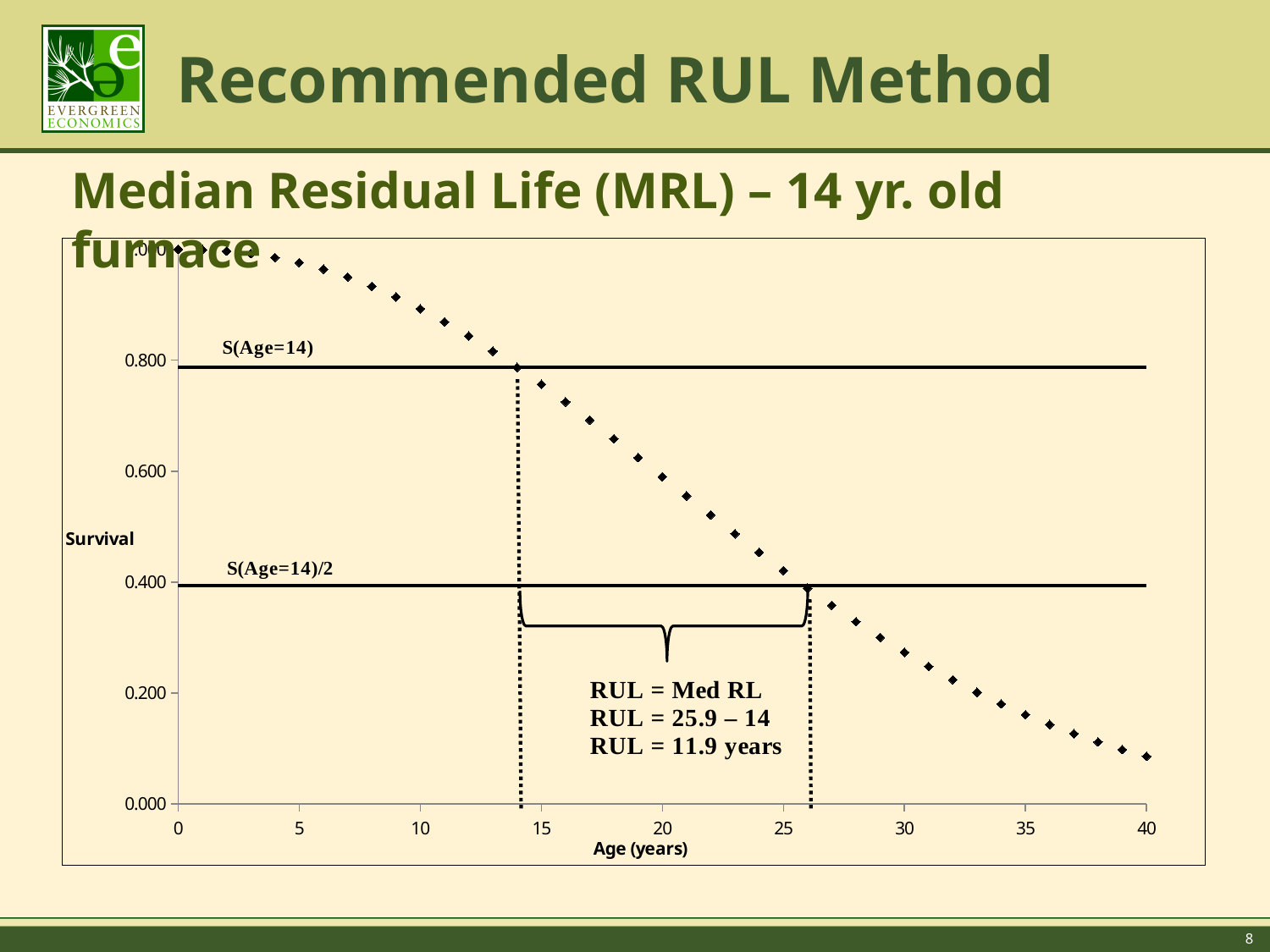
Is the survival value at age 30 greater or less than 0.400? less What is the RUL value stated in the annotation on the chart? 11.9 years Is the survival value at age 5 greater or less than 0.800? greater What kind of chart is shown on the slide? scatter chart Which has the higher survival value, age 10 or age 25? age 10 What label is given to the upper horizontal line on the chart? S(Age=14) Do the survival values rise or fall as age increases along the x axis? fall Is the survival value at age 20 greater or less than 0.400? greater What is the label of the x axis? Age (years) According to the annotation, what age is subtracted from 25.9 to compute the RUL? 14